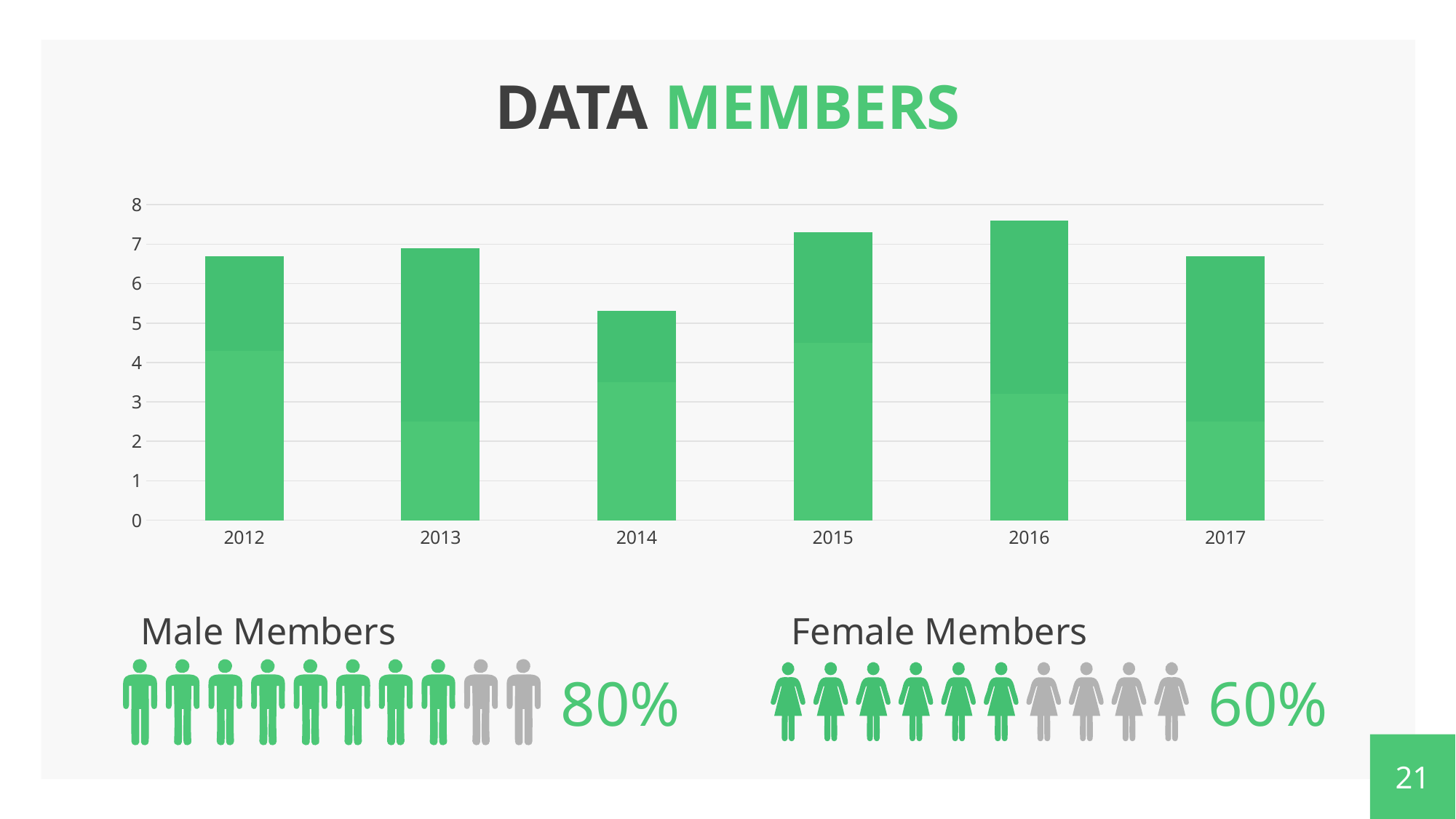
Is the total bar height for 2016 greater or less than 7? greater Is the total bar height for 2015 greater or less than 7? greater Is the total bar height for 2014 greater or less than 6? less How many years are shown on the x axis of the chart? 6 What percentage is shown next to the Male Members icons below the chart? 80% Which bar is taller, 2016 or 2014? 2016 Which year has the shortest bar in the chart? 2014 Which year has the tallest bar in the chart? 2016 What kind of chart is shown on the slide? bar chart What is the title of the slide containing the chart? DATA MEMBERS Which bar is taller, 2014 or 2015? 2015